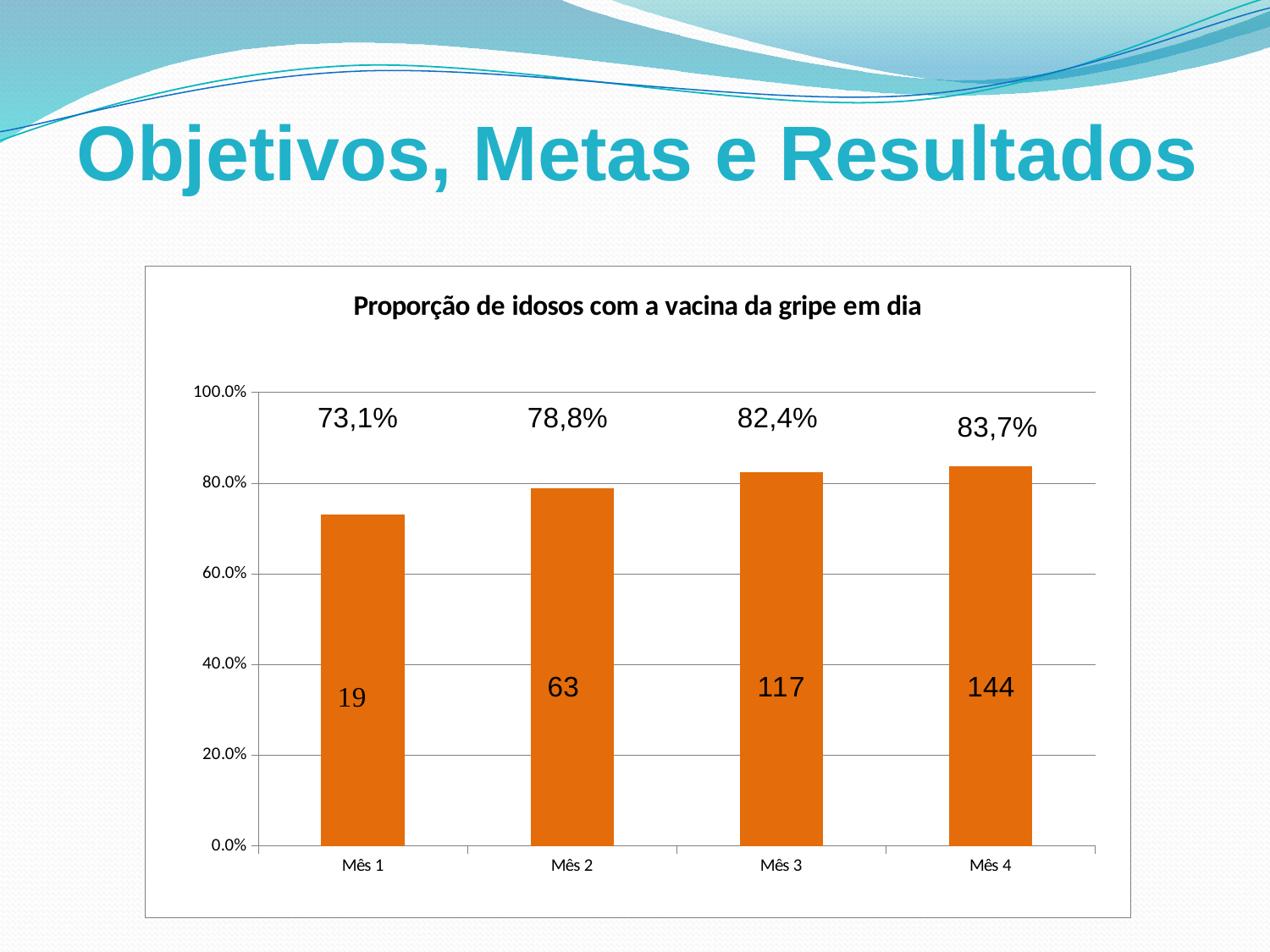
How many months are shown on the x axis? 4 What is the difference between the numbers printed inside the bars for Mês 4 and Mês 3? 27 Which is larger, the percentage for Mês 2 or for Mês 3? Mês 3 What kind of chart is shown? Bar chart Which month has the highest percentage? Mês 4 Which month has the lowest percentage? Mês 1 Do the percentages rise or fall from Mês 1 to Mês 4? Rise What is the percentage shown for Mês 3? 82,4% What number is printed inside the bar for Mês 4? 144 What is the percentage shown for Mês 1? 73,1% What is the difference in percentage points between Mês 2 and Mês 1? 5,7 What number is printed inside the bar for Mês 2? 63